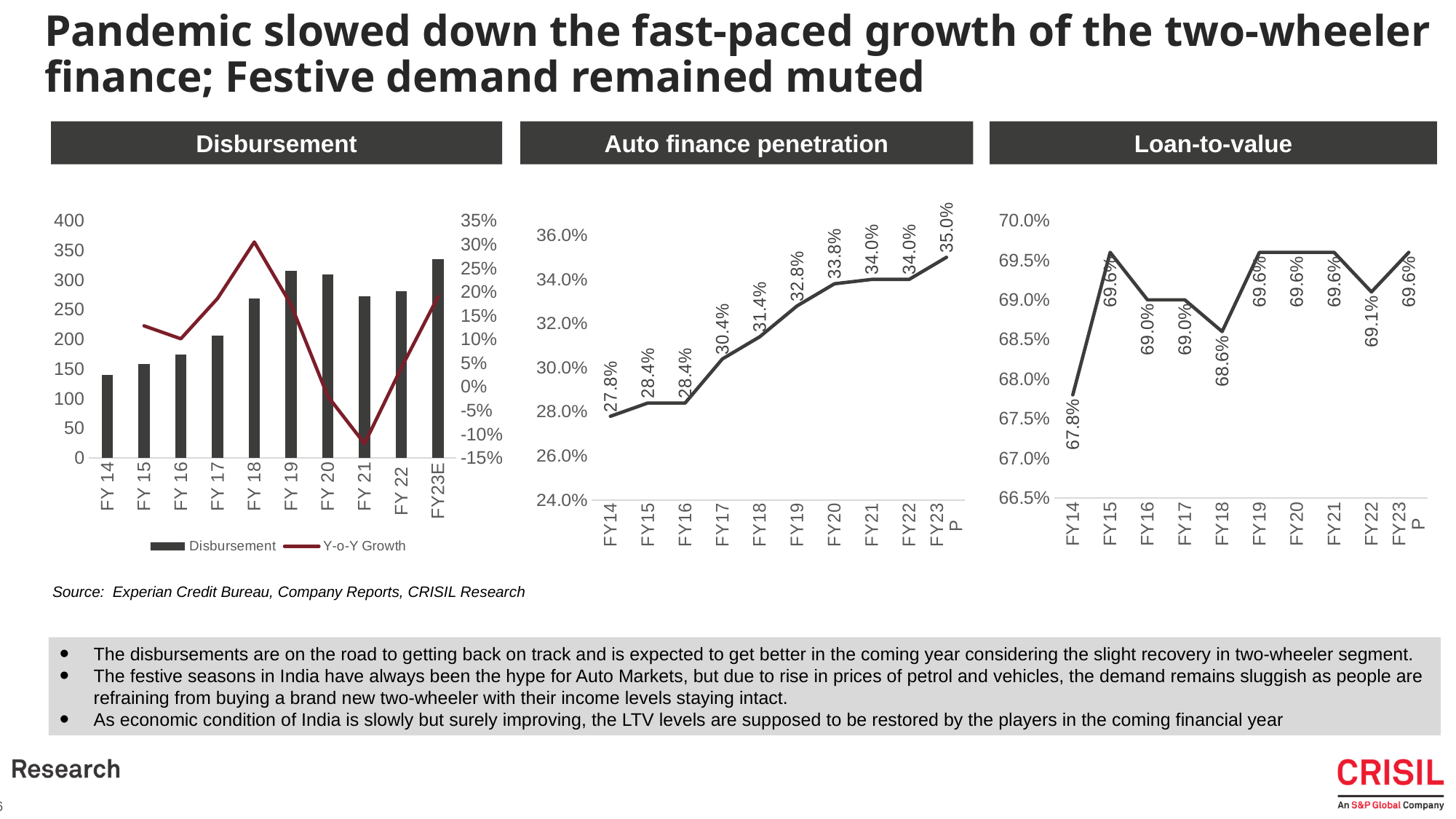
In the Disbursement chart, how many series does the legend list? 2 In the Auto finance penetration chart, what is the difference between the FY23 P value and the FY14 value? 7.2% In the Disbursement chart, which year has the lowest disbursement bar? FY 14 In the Loan-to-value chart, which year has the lowest value? FY14 In the Disbursement chart, is the disbursement value for FY 17 greater or less than 250? less In the Disbursement chart, is the disbursement value for FY 19 greater or less than 300? greater In the Auto finance penetration chart, what is the value for FY19? 32.8% In the Disbursement chart, what kind of chart is used for the Disbursement series? Bar chart In the Auto finance penetration chart, does the value generally rise or fall from FY14 to FY23 P? Rise In the Disbursement chart, in which year does the Y-o-Y Growth line reach its lowest point? FY 21 In the Auto finance penetration chart, how many data points are plotted? 10 In the Loan-to-value chart, what is the value for FY18? 68.6%